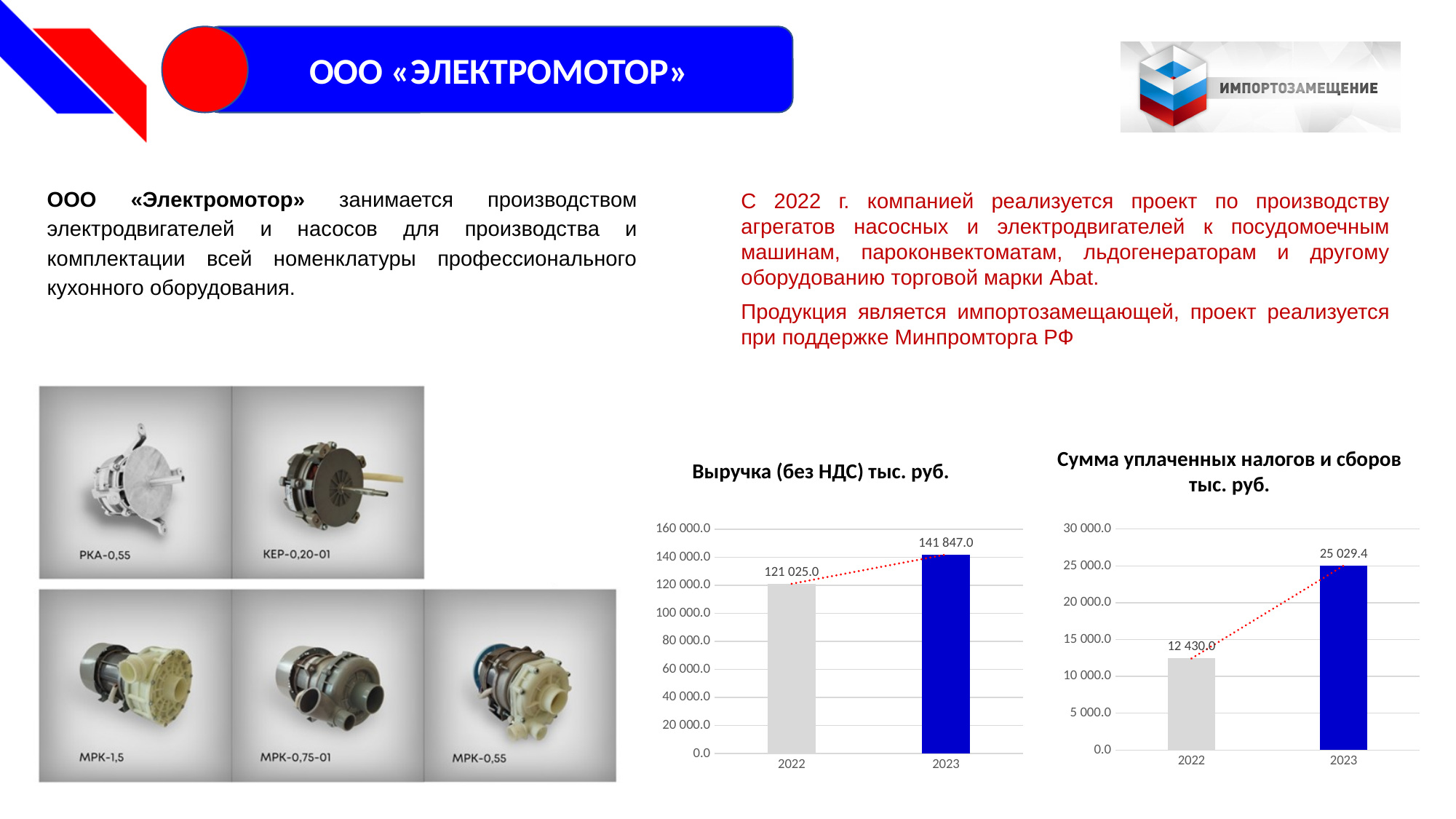
In the chart titled «Выручка (без НДС) тыс. руб.», what is the difference between the 2023 and 2022 values? 20 822.0 In the chart titled «Сумма уплаченных налогов и сборов тыс. руб.», which year has the lower value? 2022 In the chart titled «Выручка (без НДС) тыс. руб.», what is the value for 2023? 141 847.0 In the chart titled «Выручка (без НДС) тыс. руб.», what is the value for 2022? 121 025.0 In the chart titled «Выручка (без НДС) тыс. руб.», which year has the higher value? 2023 In the chart titled «Сумма уплаченных налогов и сборов тыс. руб.», is the value for 2022 greater or less than 15 000.0? less In the chart titled «Сумма уплаченных налогов и сборов тыс. руб.», what is the value for 2022? 12 430.0 How many categories (years) are shown in the chart titled «Выручка (без НДС) тыс. руб.»? 2 What kind of chart is the chart titled «Сумма уплаченных налогов и сборов тыс. руб.»? bar chart In the chart titled «Выручка (без НДС) тыс. руб.», do the values rise or fall from 2022 to 2023? rise In the chart titled «Сумма уплаченных налогов и сборов тыс. руб.», what is the value for 2023? 25 029.4 In the chart titled «Сумма уплаченных налогов и сборов тыс. руб.», what is the difference between the 2023 and 2022 values? 12 599.4